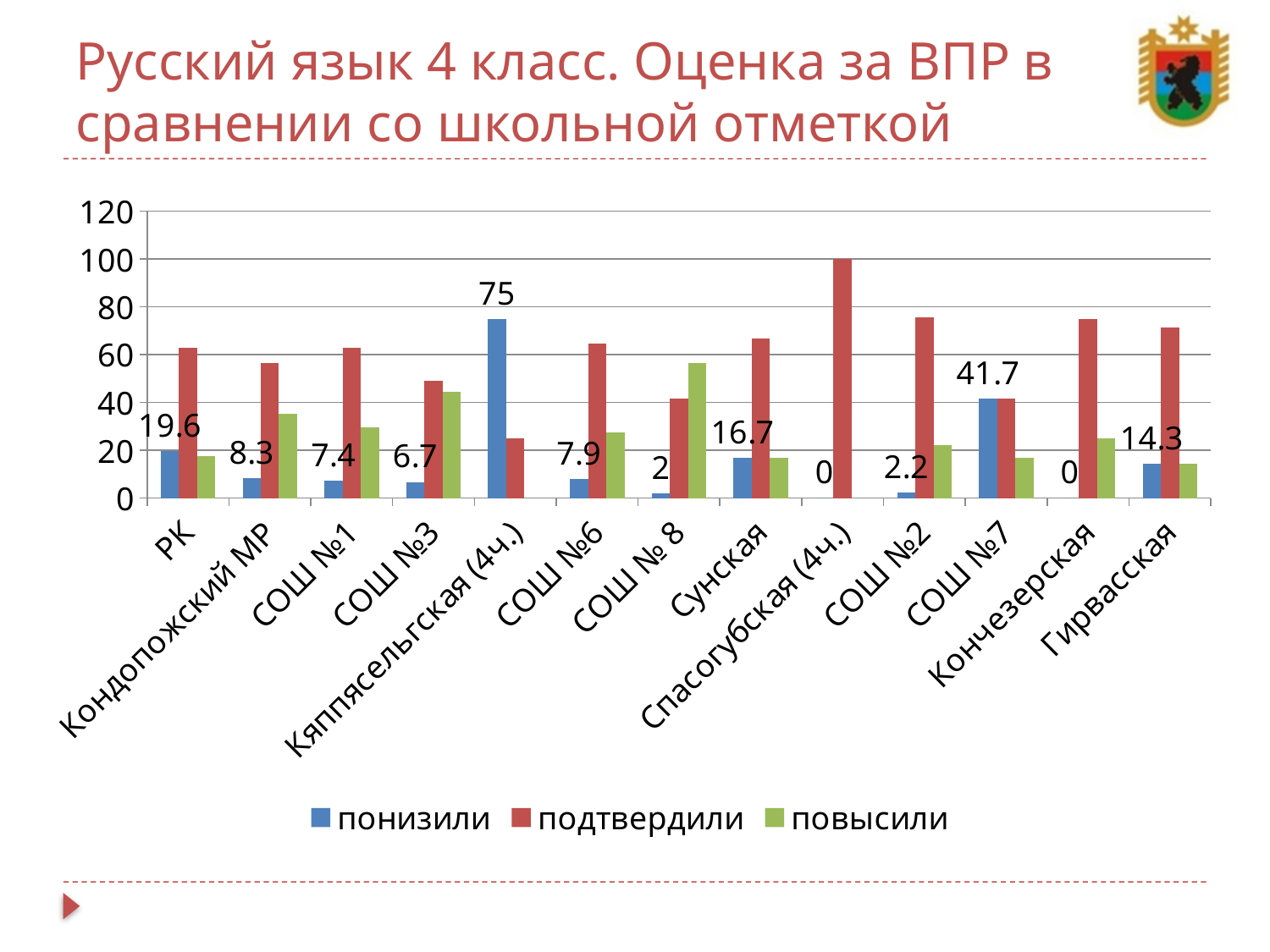
Which is larger, the 'понизили' value for Сунская or for Кондопожский МР? Сунская Is the 'подтвердили' value for Спасогубская (4ч.) greater or less than 80? greater Which category has the highest value for 'понизили'? Кяппясельгская (4ч.) How many categories are shown on the x axis? 13 What type of chart is shown on the slide? bar chart What is the value of 'понизили' for СОШ №7? 41.7 How many series does the legend list? 3 What is the difference between the 'понизили' values for Кяппясельгская (4ч.) and СОШ №7? 33.3 What is the value of 'понизили' for РК? 19.6 What is the value of 'понизили' for Кяппясельгская (4ч.)? 75 Which category has the highest value for 'подтвердили'? Спасогубская (4ч.)